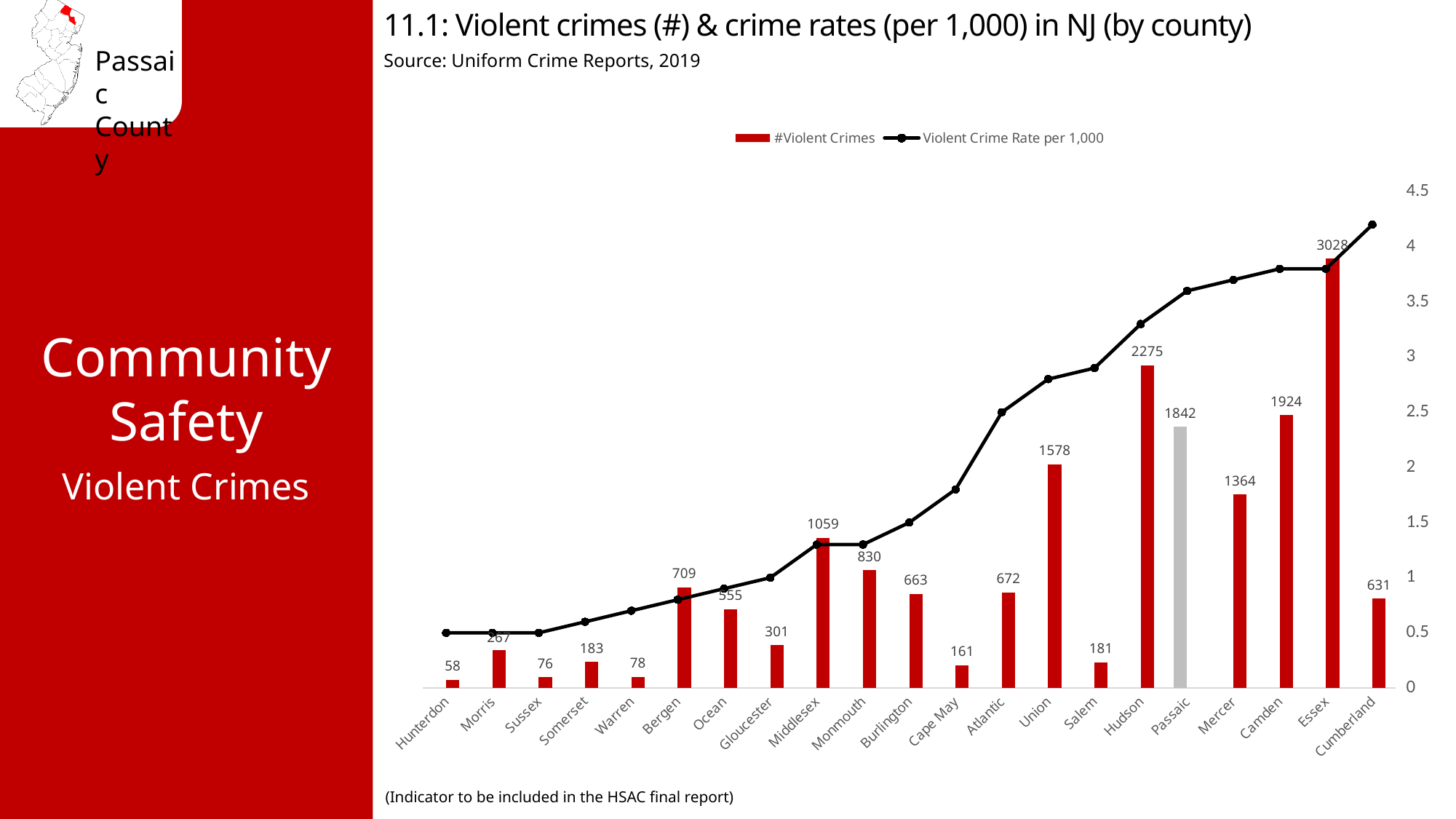
What is the number of violent crimes for Essex County? 3028 Does the violent crime rate per 1,000 line generally rise or fall from left to right across the counties? rise How many series does the legend list? 2 How many counties are shown on the x axis of the chart? 21 Is the violent crime rate per 1,000 for Cumberland greater or less than 4? greater Is the violent crime rate per 1,000 for Hunterdon greater or less than 1? less Which county has the highest number of violent crimes? Essex Which county has the lowest number of violent crimes? Hunterdon What is the source cited for the chart? Uniform Crime Reports, 2019 What is the number of violent crimes for Passaic County? 1842 Which county has more violent crimes, Camden or Hudson? Hudson What is the difference in the number of violent crimes between Hudson and Passaic? 433